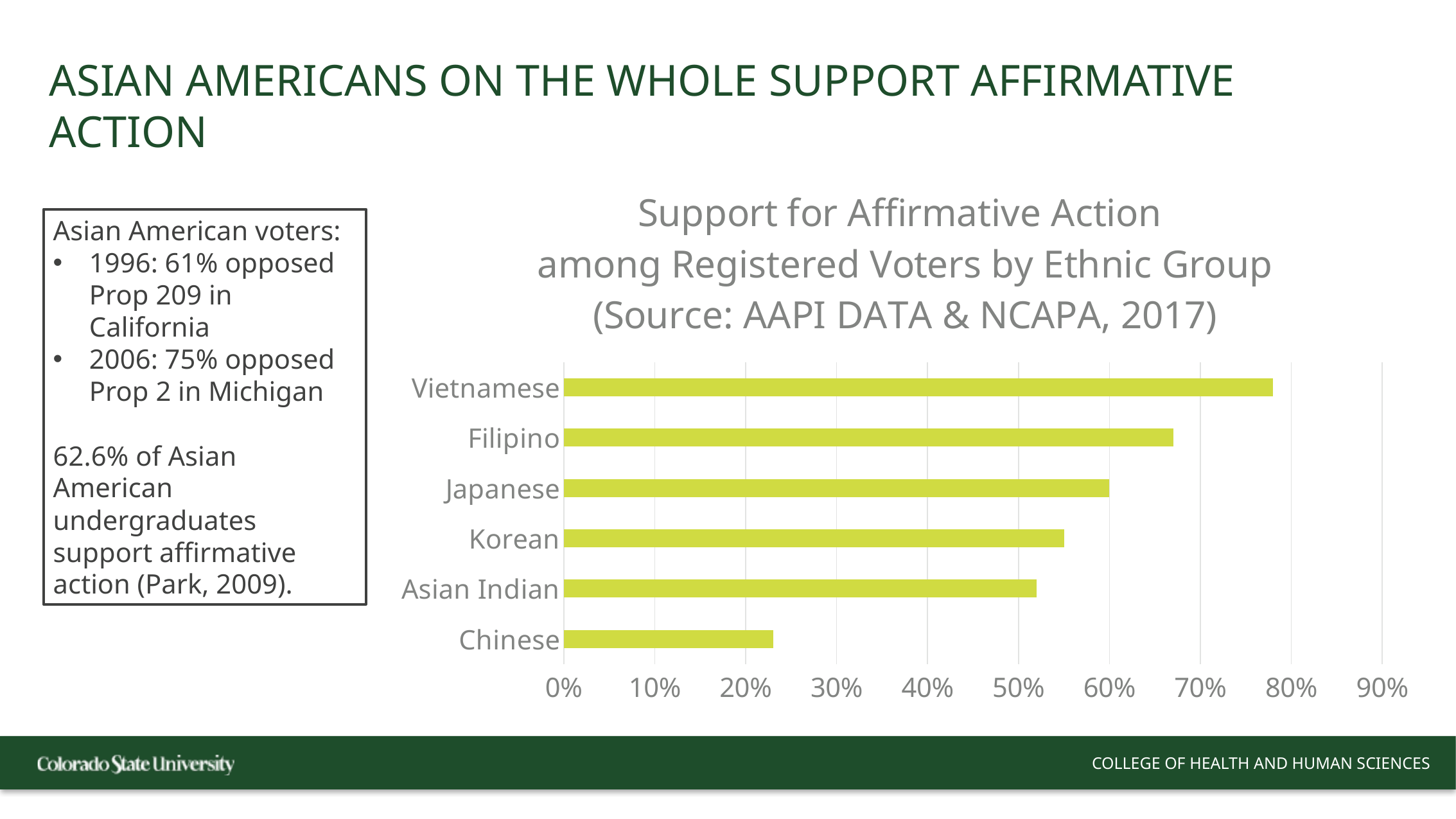
Is the value for Filipino greater or less than 60%? greater Is the value for Chinese greater or less than 30%? less According to the chart title, what is the source of the data? AAPI DATA & NCAPA, 2017 Which ethnic group shows the lowest support for affirmative action? Chinese Is the value for Asian Indian greater or less than 40%? greater Which is larger, the value for Filipino or the value for Japanese? Filipino How many ethnic groups are plotted in the chart? 6 Which is larger, the value for Chinese or the value for Korean? Korean What kind of chart is shown on the slide? bar chart Which ethnic group shows the highest support for affirmative action? Vietnamese